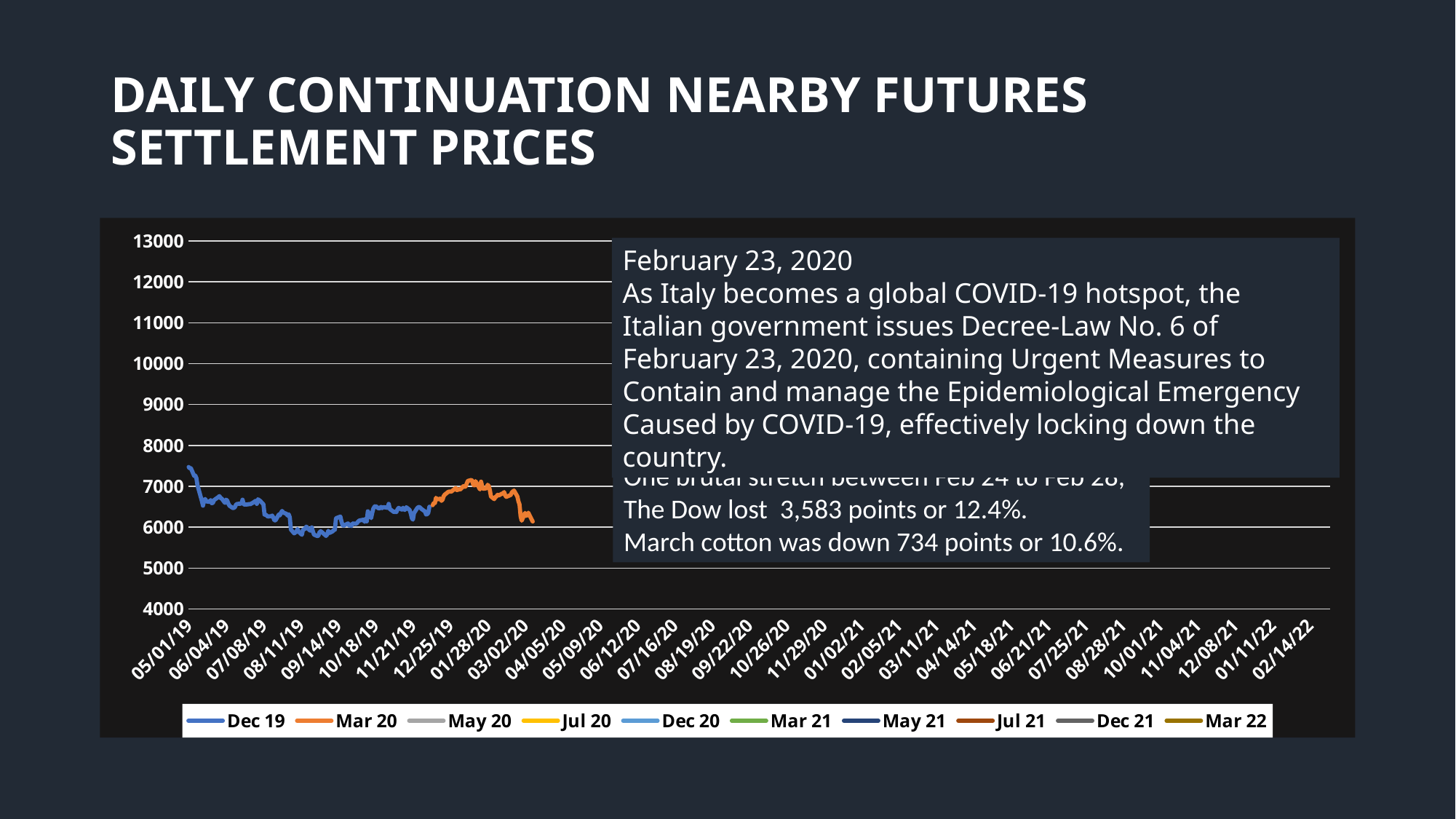
Is the peak of the Mar 20 series greater or less than 6000? greater What is the last date label on the horizontal axis? 02/14/22 Is the lowest point of the Dec 19 series greater or less than 7000? less Is the value of the Dec 19 series at the start of the chart (05/01/19) greater or less than 7000? greater What is the title of the slide's chart? DAILY CONTINUATION NEARBY FUTURES SETTLEMENT PRICES How many series does the chart's legend list? 10 What is the highest value shown on the vertical axis? 13000 What kind of chart is shown on the slide? line chart Does the Mar 20 series rise or fall over its final stretch toward 03/02/20? fall What is the lowest value shown on the vertical axis? 4000 Which legend series is drawn in orange? Mar 20